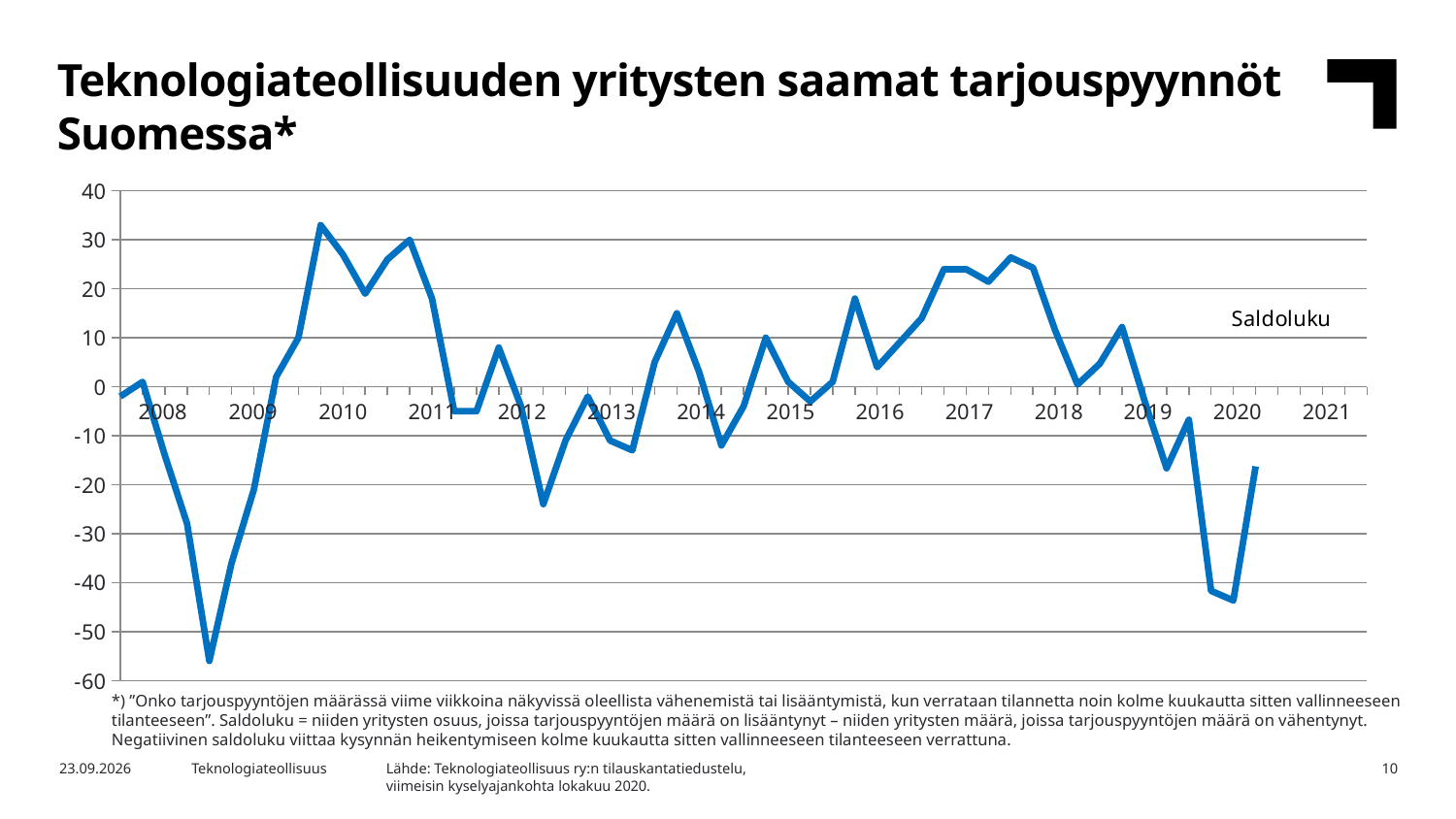
Is the lowest value of the line in 2009 greater or less than -50? less What is the title of the chart on the slide? Teknologiateollisuuden yritysten saamat tarjouspyynnöt Suomessa* Does the line rise or fall between the 2018 peak and the 2020 low? fall Is the lowest value of the line in 2012 greater or less than -20? less What kind of chart is shown on the slide? line chart How many year labels are shown on the x axis? 14 In which year does the line reach its lowest point? 2009 How many series does the chart show? 1 What is the name of the series plotted in the chart? Saldoluku Is the lowest value of the line in 2020 greater or less than -40? less